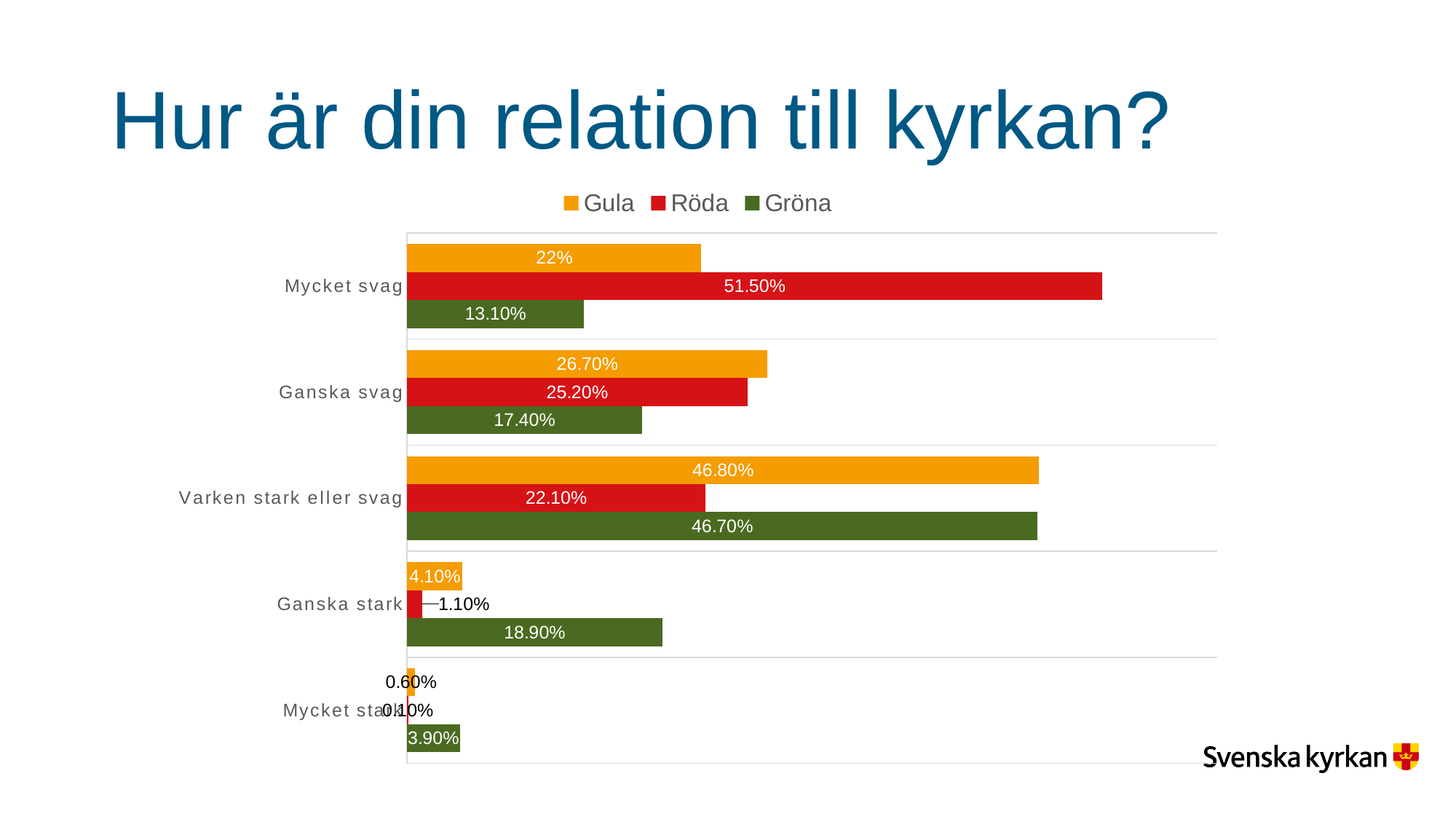
What is the difference between the Röda and Gula values in the Mycket svag category? 29.50% What is the value for Gula in the Varken stark eller svag category? 46.80% What kind of chart is shown on the slide? Bar chart What is the value for Gröna in the Ganska stark category? 18.90% How many series does the legend list? 3 Which category has the lowest value for the Gröna series? Mycket stark How many categories are shown on the chart? 5 What is the value for Röda in the Mycket svag category? 51.50% In the Ganska stark category, which series has the larger value, Gula or Gröna? Gröna Which series is shown in red in the legend? Röda What is the difference between the Gula and Gröna values in the Ganska svag category? 9.30% Which category has the highest value for the Röda series? Mycket svag